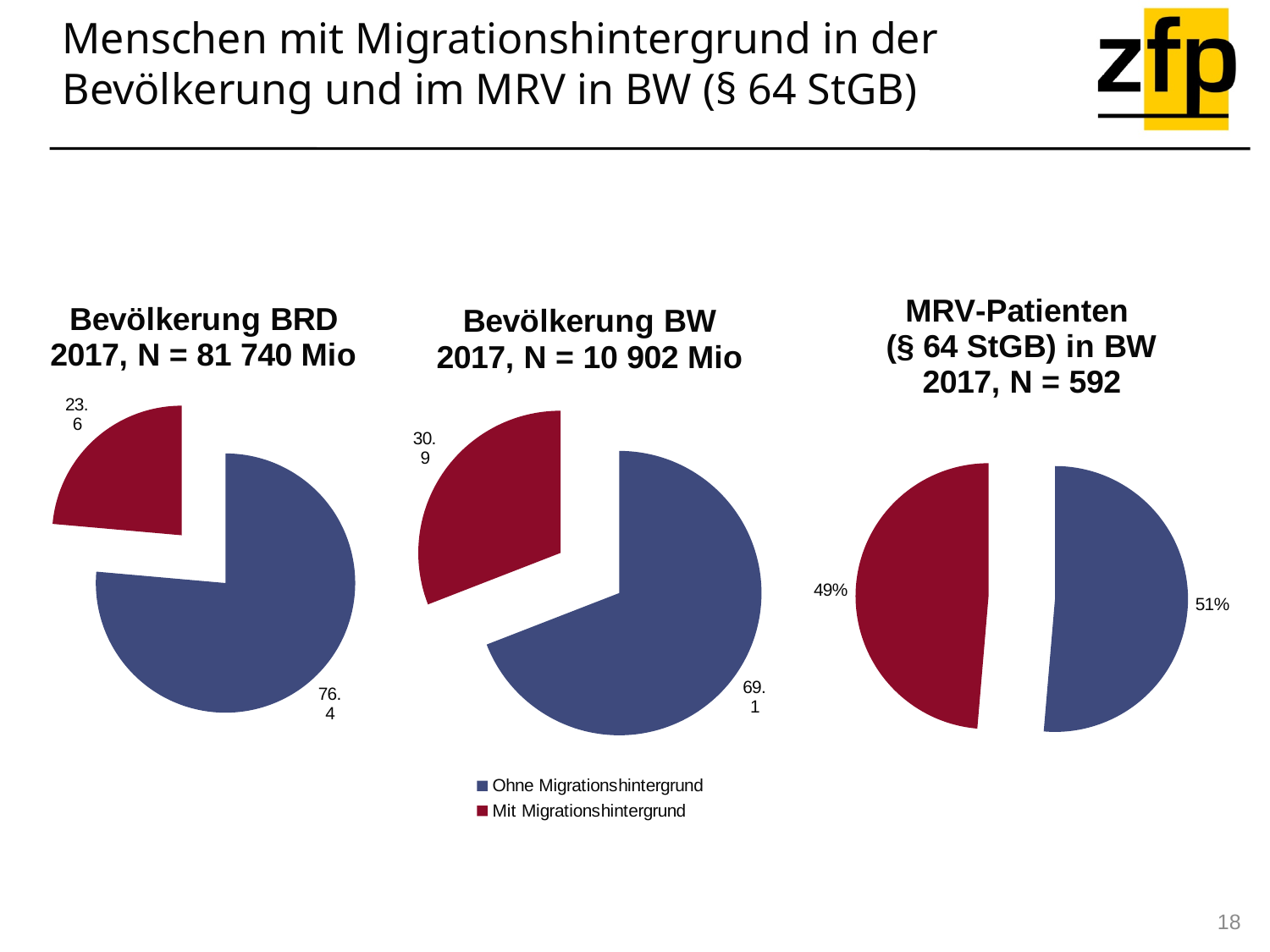
Which is larger: the 'Mit Migrationshintergrund' value in the 'Bevölkerung BRD 2017' chart or in the 'Bevölkerung BW 2017' chart? Bevölkerung BW 2017 In the 'Bevölkerung BW 2017' chart, which category has the smallest slice? Mit Migrationshintergrund How many entries does the legend list for the charts on the slide? 2 In the 'Bevölkerung BRD 2017' chart, what is the value for 'Ohne Migrationshintergrund'? 76.4 In the 'Bevölkerung BW 2017' chart, what is the difference between the 'Ohne Migrationshintergrund' and 'Mit Migrationshintergrund' values? 38.2 What type of chart is used for the 'MRV-Patienten (§ 64 StGB) in BW 2017' chart? Pie chart In the 'Bevölkerung BRD 2017' chart, which category has the largest slice? Ohne Migrationshintergrund In the 'Bevölkerung BRD 2017' chart, what is the value for 'Mit Migrationshintergrund'? 23.6 In the 'Bevölkerung BW 2017' chart, what is the value for 'Mit Migrationshintergrund'? 30.9 In the 'MRV-Patienten (§ 64 StGB) in BW 2017' chart, what is the value for 'Mit Migrationshintergrund'? 49% In the 'MRV-Patienten (§ 64 StGB) in BW 2017' chart, what is the value for 'Ohne Migrationshintergrund'? 51% In the 'Bevölkerung BW 2017' chart, what is the value for 'Ohne Migrationshintergrund'? 69.1